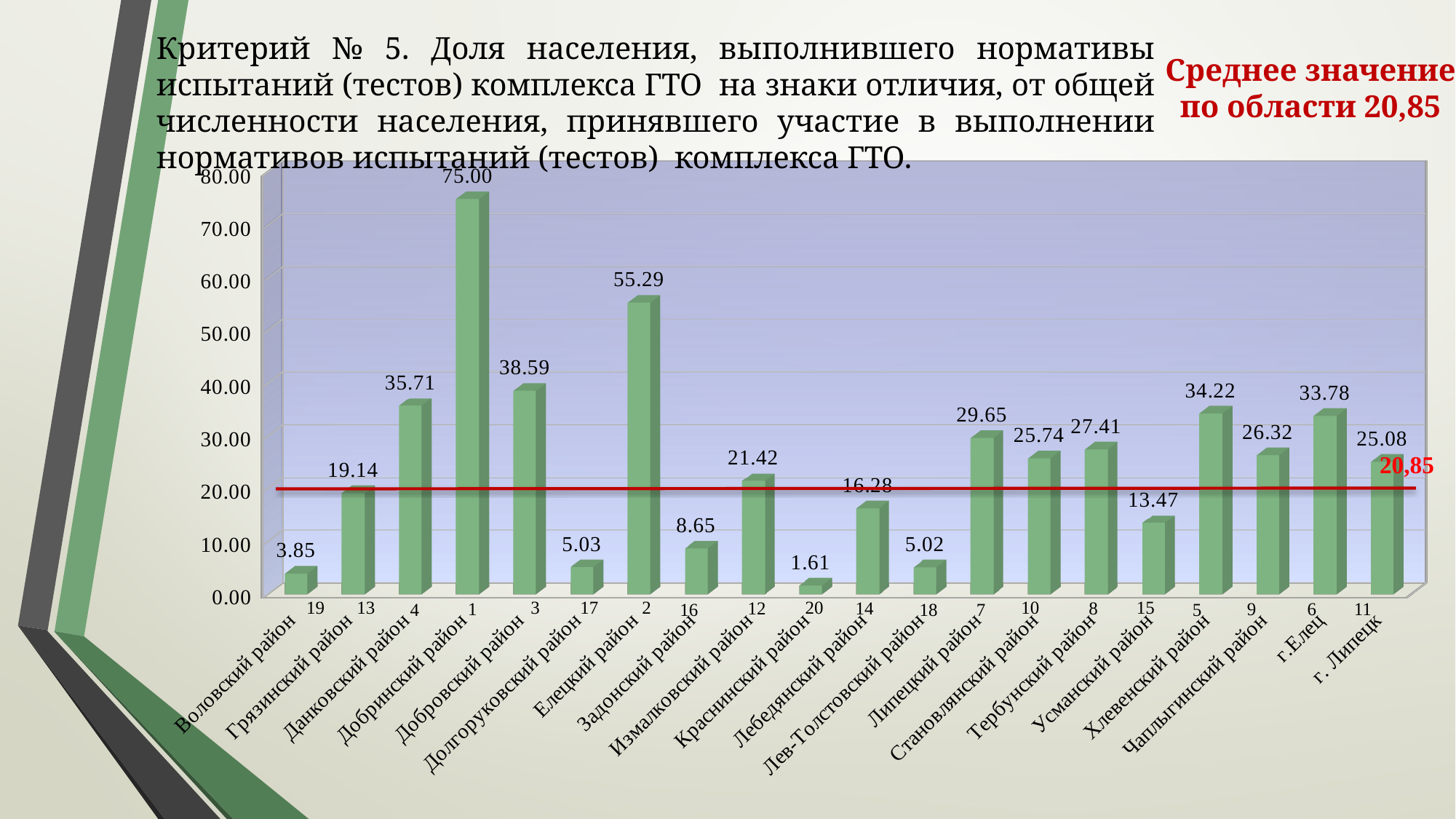
What is the regional average value marked by the red line? 20,85 What is the value for Усманский район? 13.47 How many districts are shown on the chart? 20 Which district has the lowest value? Краснинский район What kind of chart is shown on the slide? bar chart What is the difference between the values for Добринский район and Елецкий район? 19.71 Which district has the highest value? Добринский район What is the value for Елецкий район? 55.29 Is the value for Лебедянский район greater or less than 20.00? less What is the value for г. Липецк? 25.08 What is the value for Добринский район? 75.00 Which is larger, the value for Хлевенский район or the value for г.Елец? Хлевенский район